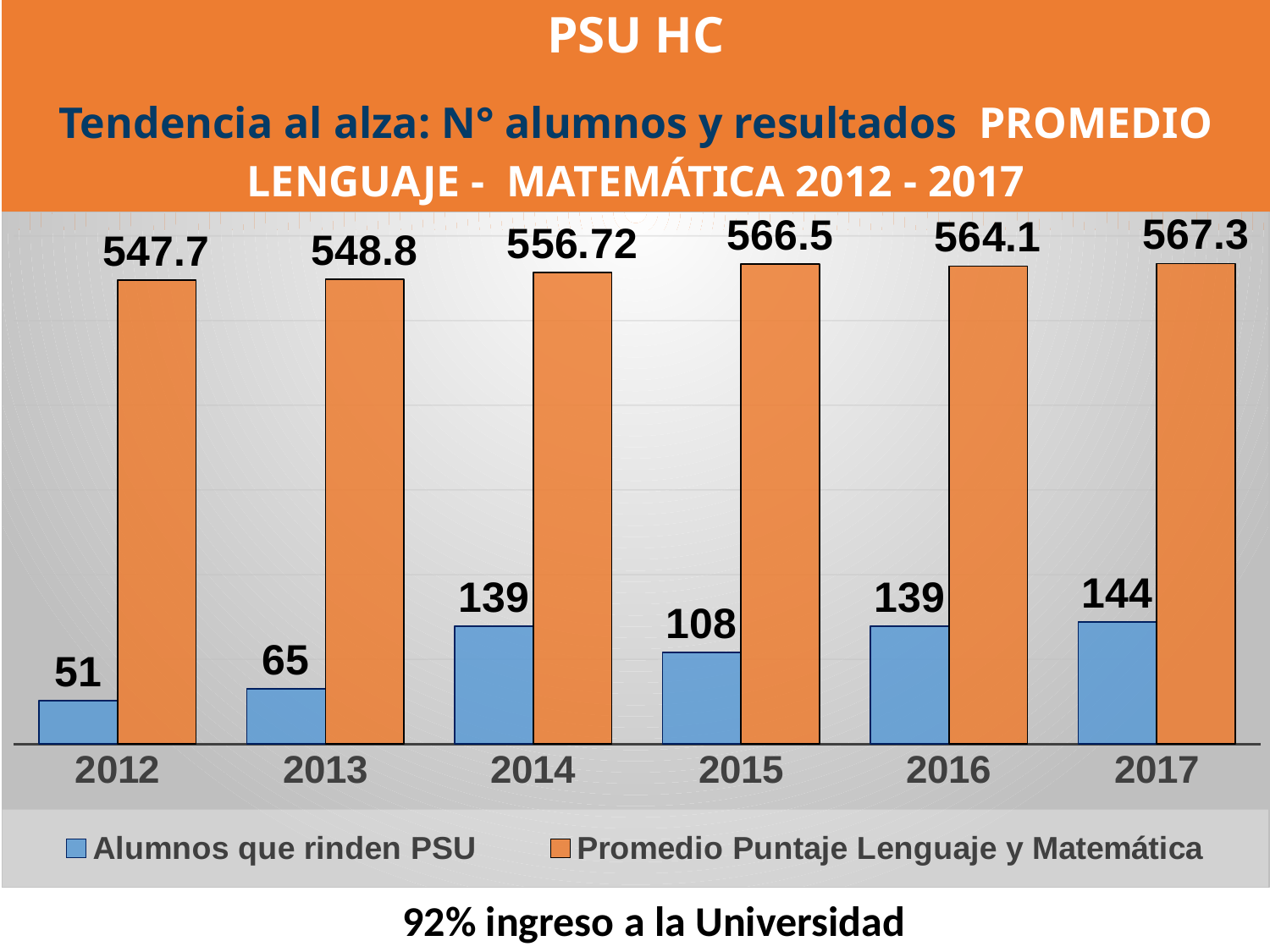
In which year was the Promedio Puntaje Lenguaje y Matemática lowest? 2012 Does the Promedio Puntaje Lenguaje y Matemática generally rise or fall from 2012 to 2017? Rise How many series does the legend list? 2 What is the difference in Alumnos que rinden PSU between 2017 and 2012? 93 How many students took the PSU (Alumnos que rinden PSU) in 2015? 108 What was the Promedio Puntaje Lenguaje y Matemática in 2014? 556.72 What colour are the bars for Alumnos que rinden PSU? Blue Which year had a higher Promedio Puntaje Lenguaje y Matemática, 2015 or 2016? 2015 What kind of chart is shown on the slide? Bar chart How many years are shown on the x axis of the chart? 6 In which year was the number of Alumnos que rinden PSU highest? 2017 What is the difference in Promedio Puntaje Lenguaje y Matemática between 2013 and 2012? 1.1